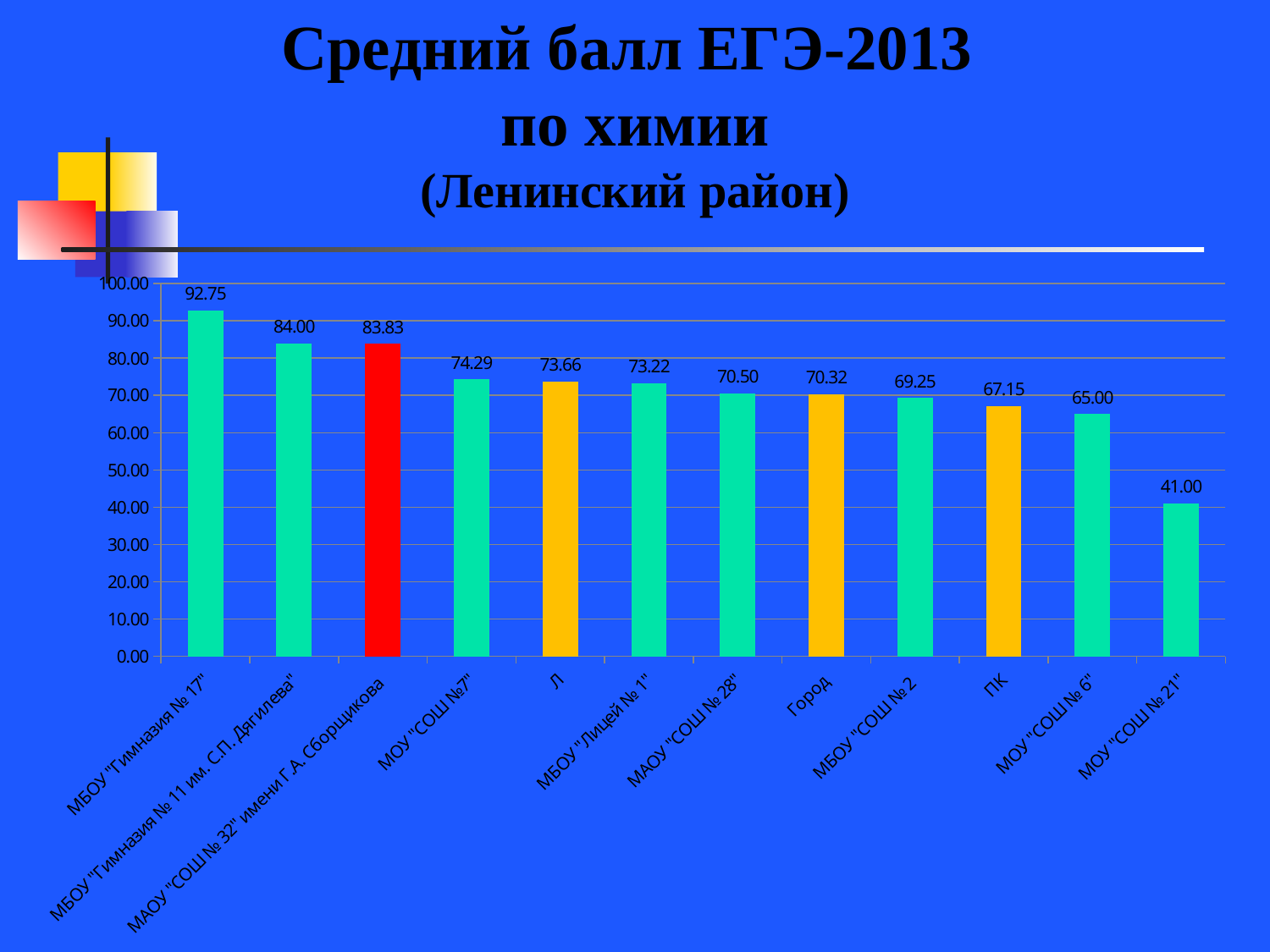
Which category has the highest value on the chart? МБОУ "Гимназия № 17" What value is shown for МОУ "СОШ № 21"? 41.00 What value is shown for the category Город? 70.32 What is the difference between the values for МБОУ "Гимназия № 17" and МОУ "СОШ № 21"? 51.75 What is the average chemistry score shown for МБОУ "Гимназия № 17"? 92.75 Which is larger, the value for МАОУ "СОШ № 28" or the value for ПК? МАОУ "СОШ № 28" What kind of chart is shown on the slide? Bar chart What value is shown for МБОУ "Лицей № 1"? 73.22 How many categories (bars) are shown on the chart? 12 Which bar is coloured red on the chart? МАОУ "СОШ № 32" имени Г.А. Сборщикова Which category has the lowest value on the chart? МОУ "СОШ № 21" What is the difference between the values for МОУ "СОШ №7" and Л? 0.63